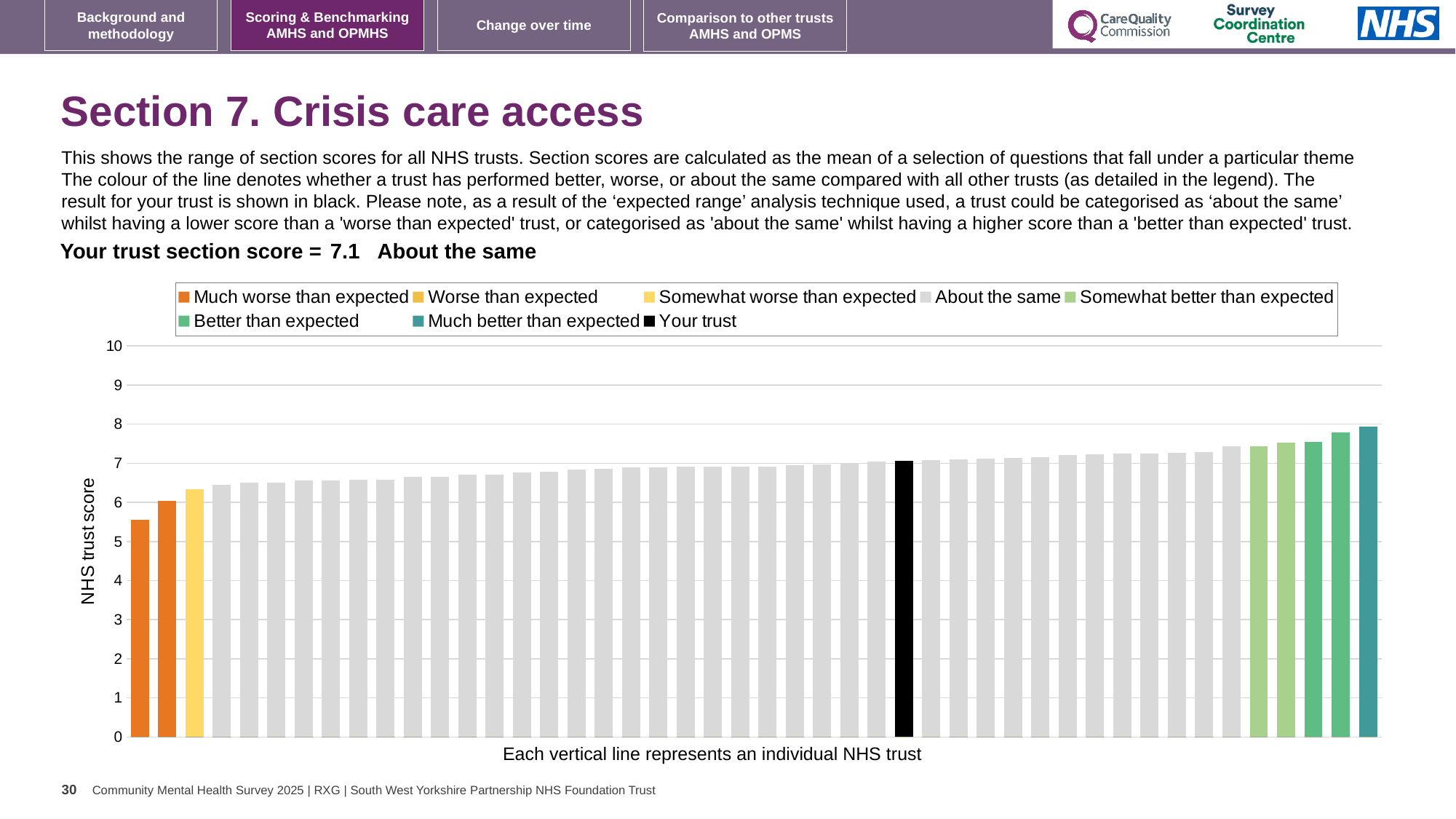
Is the value of the lowest bar (leftmost orange bar) greater or less than 6? less Do the bar values rise or fall from left to right along the x axis? rise Is the value of the highest bar (rightmost bar) greater or less than 7? greater Which category does your trust fall into for this section? About the same Is the value of the black 'Your trust' bar greater or less than 6? greater How many bars are coloured as 'Much worse than expected'? 2 How many entries does the chart legend list? 8 Which is larger: the value of the black 'Your trust' bar or the value of the leftmost orange bar? Your trust What is the section score for your trust shown on the slide? 7.1 What kind of chart is shown on the slide? bar chart How many bars are coloured as 'Much better than expected'? 1 What is the label on the vertical axis of the chart? NHS trust score